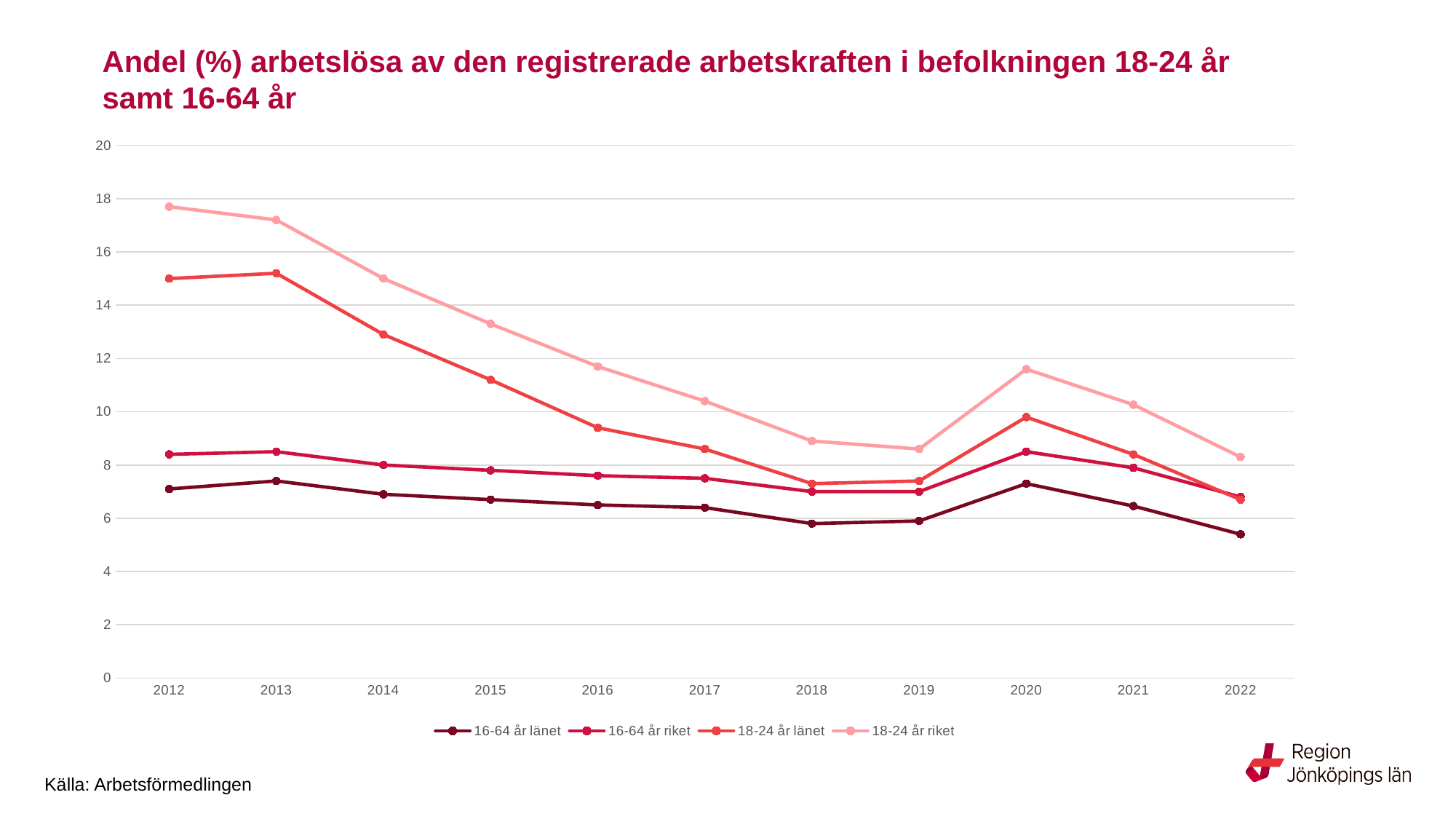
Does the value for 18-24 år riket rise or fall from 2012 to 2018? fall In 2016, which is larger: 18-24 år riket or 18-24 år länet? 18-24 år riket How many years are shown on the x axis? 11 How many series does the legend list? 4 In which year is the value for 16-64 år länet lowest? 2022 Is the value for 18-24 år riket in 2012 greater or less than 16? greater Is the value for 18-24 år länet in 2020 greater or less than 8? greater In which year is the value for 18-24 år riket highest? 2012 What source is cited for the chart? Arbetsförmedlingen For 18-24 år länet, which year has the larger value: 2019 or 2020? 2020 What kind of chart is shown on the slide? line chart Is the value for 16-64 år länet in 2022 greater or less than 6? less